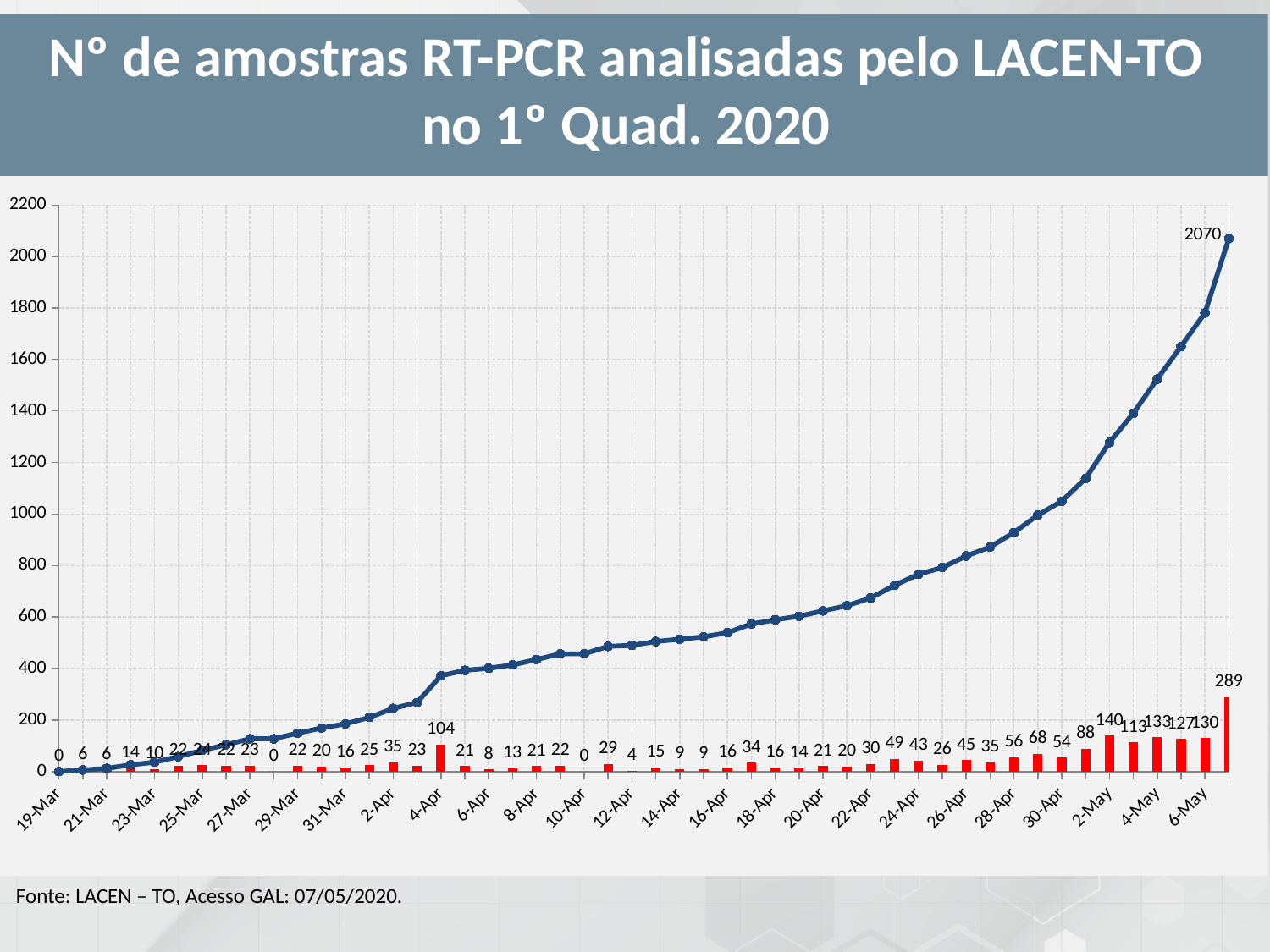
Does the blue line rise or fall from 19-Mar to the end of the chart? rises What is the title of the slide? N° de amostras RT-PCR analisadas pelo LACEN-TO no 1° Quad. 2020 What is the value of the red bar on 2-Apr? 35 Is the value of the blue line on 6-May greater or less than 1600? greater What is the value labelled at the final point of the blue line? 2070 What is the value of the red bar on 2-May? 140 What is the value of the red bar on 4-Apr? 104 What is the difference between the last red bar (289) and the red bar on 2-May (140)? 149 What is the highest value shown by the red bars? 289 What kinds of chart are combined on this slide? bar chart and line chart Is the value of the blue line on 22-Apr greater or less than 1000? less Which red bar is larger, 2-May or 4-May? 2-May